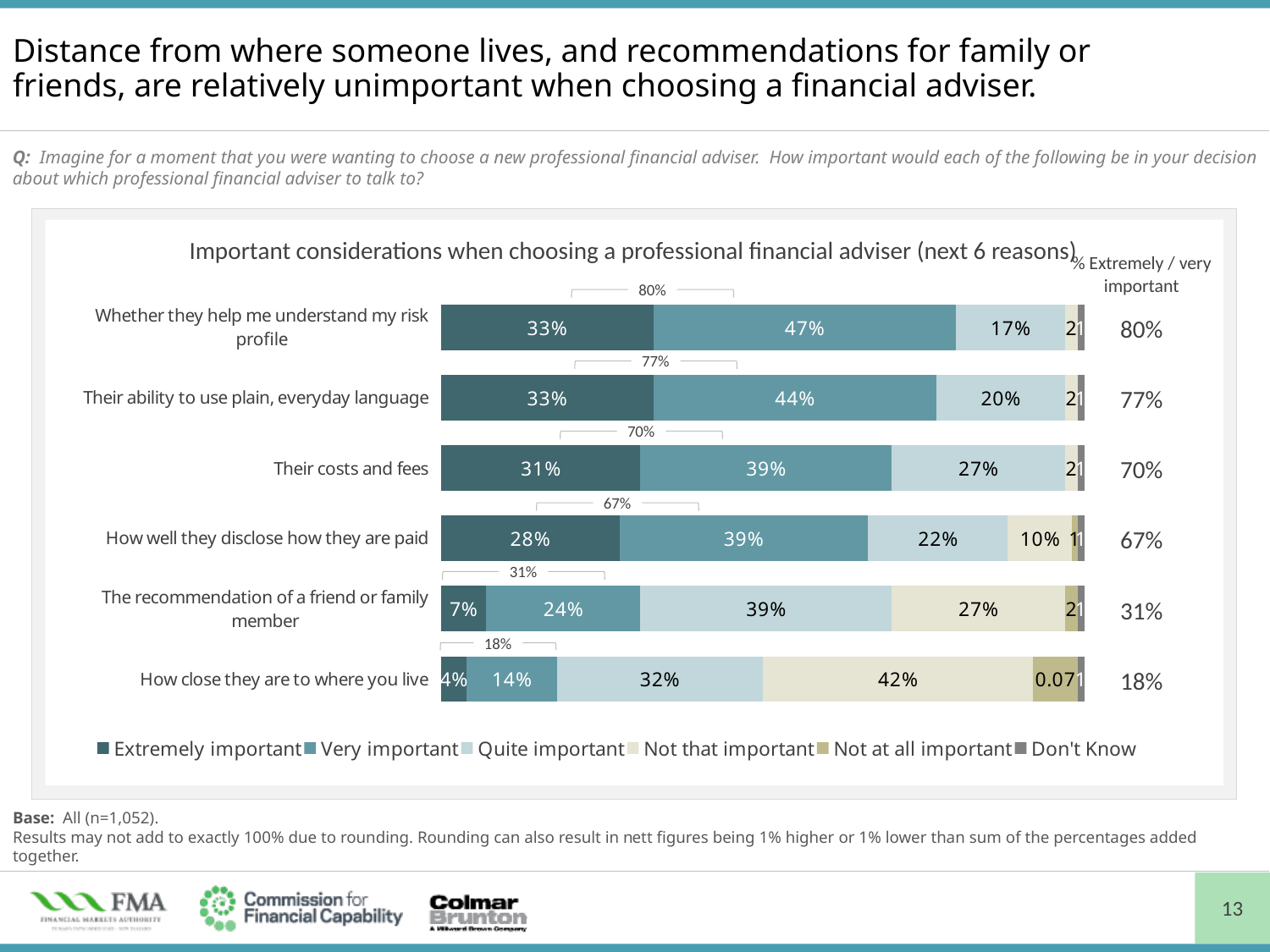
What type of chart is shown on the slide? Stacked bar chart Which has a larger Quite important percentage: 'Their costs and fees' or 'How well they disclose how they are paid'? Their costs and fees How many considerations are shown in the chart? 6 What is the nett % Extremely / very important figure for 'How well they disclose how they are paid'? 67% What is the difference in nett % Extremely / very important between 'Whether they help me understand my risk profile' and 'How close they are to where you live'? 62 percentage points What is the Quite important percentage for 'How close they are to where you live'? 32% Which consideration has the highest nett % Extremely / very important? Whether they help me understand my risk profile What percentage rated 'Whether they help me understand my risk profile' as Very important? 47% What percentage of respondents rated 'Their costs and fees' as Extremely important? 31% Which consideration has the lowest nett % Extremely / very important? How close they are to where you live What is the Not that important percentage for 'How close they are to where you live'? 42% How many series does the legend list? 6